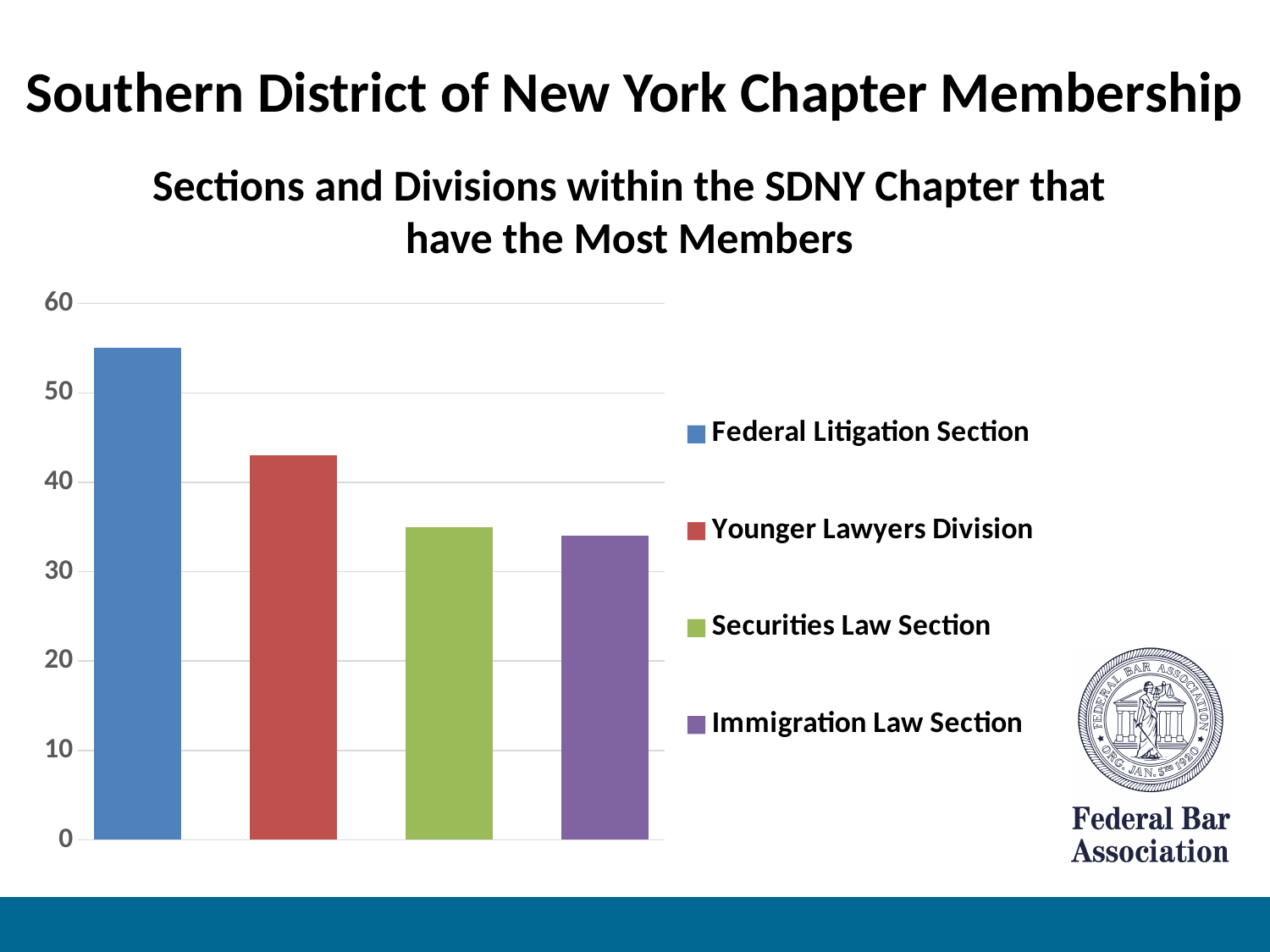
How many entries does the legend list? 4 Is the value for Immigration Law Section greater or less than 30? greater What is the title of the chart? Sections and Divisions within the SDNY Chapter that have the Most Members Is the value for Federal Litigation Section greater or less than 50? greater Do the bar values rise or fall from left to right across the chart? fall Is the value for Federal Litigation Section greater or less than 60? less What kind of chart is shown on the slide? bar chart Which section or division has the highest number of members in the chart? Federal Litigation Section How many bars are plotted in the chart? 4 Which has more members, Federal Litigation Section or Younger Lawyers Division? Federal Litigation Section